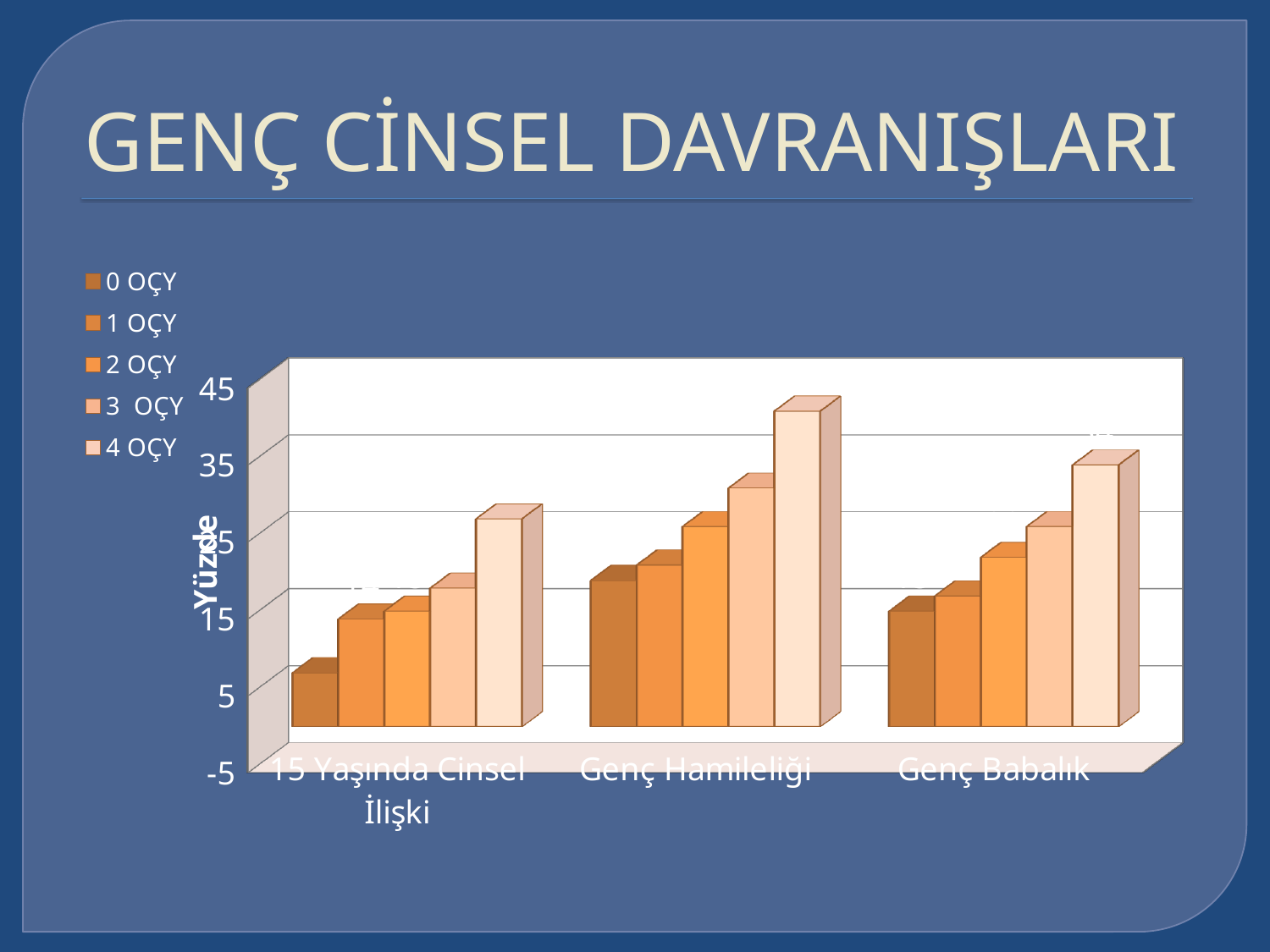
What kind of chart is shown on the slide? bar chart Which category contains the tallest bar in the whole chart? Genç Hamileliği How many series does the chart's legend list? 5 How many categories are shown on the x axis of the chart? 3 Which series has the shortest bar in the 15 Yaşında Cinsel İlişki category? 0 OÇY Within the Genç Babalık category, do the values rise or fall going from 0 OÇY to 4 OÇY? rise Which is larger: the 4 OÇY value for Genç Hamileliği or the 4 OÇY value for Genç Babalık? Genç Hamileliği Is the value for 0 OÇY in the 15 Yaşında Cinsel İlişki category greater or less than 15? less Which series has the tallest bar in the Genç Hamileliği category? 4 OÇY What is the title of the vertical axis of the chart? Yüzde Is the value for 4 OÇY in the Genç Hamileliği category greater or less than 35? greater Is the value for 0 OÇY in the Genç Hamileliği category greater or less than 15? greater